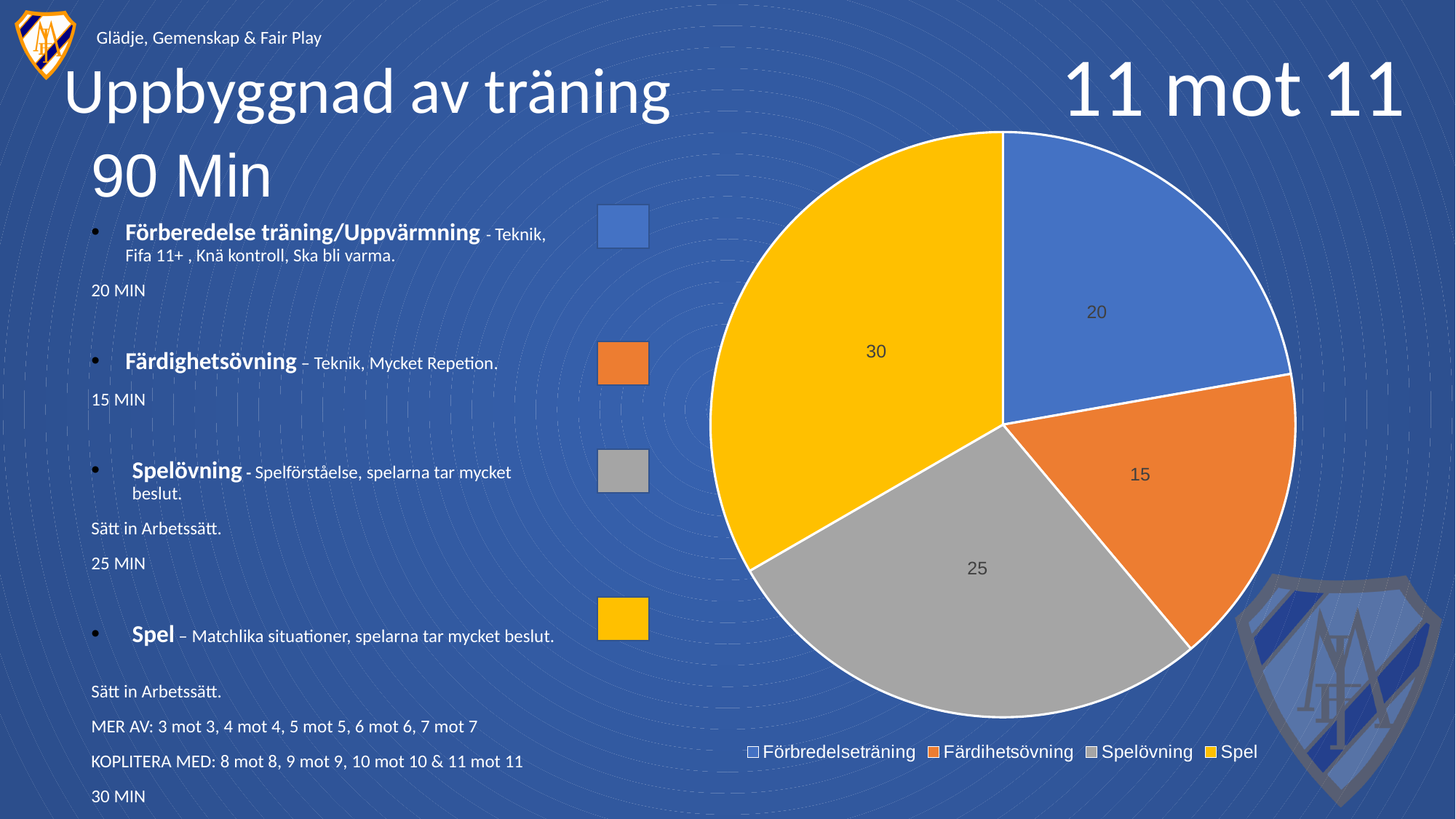
What value is shown for the Förbredelseträning slice in the pie chart? 20 What is the total of all the slice values in the pie chart? 90 What value is shown for the Färdihetsövning slice in the pie chart? 15 Which is larger in the pie chart, Spelövning or Förbredelseträning? Spelövning What value is shown for the Spelövning slice in the pie chart? 25 What colour is the Spel slice in the pie chart? Yellow Which slice of the pie chart has the largest value? Spel How many slices does the pie chart have? 4 Which slice of the pie chart has the smallest value? Färdihetsövning What value is shown for the Spel slice in the pie chart? 30 What type of chart is shown on the slide? Pie chart What is the difference between the Spel value and the Färdihetsövning value in the pie chart? 15